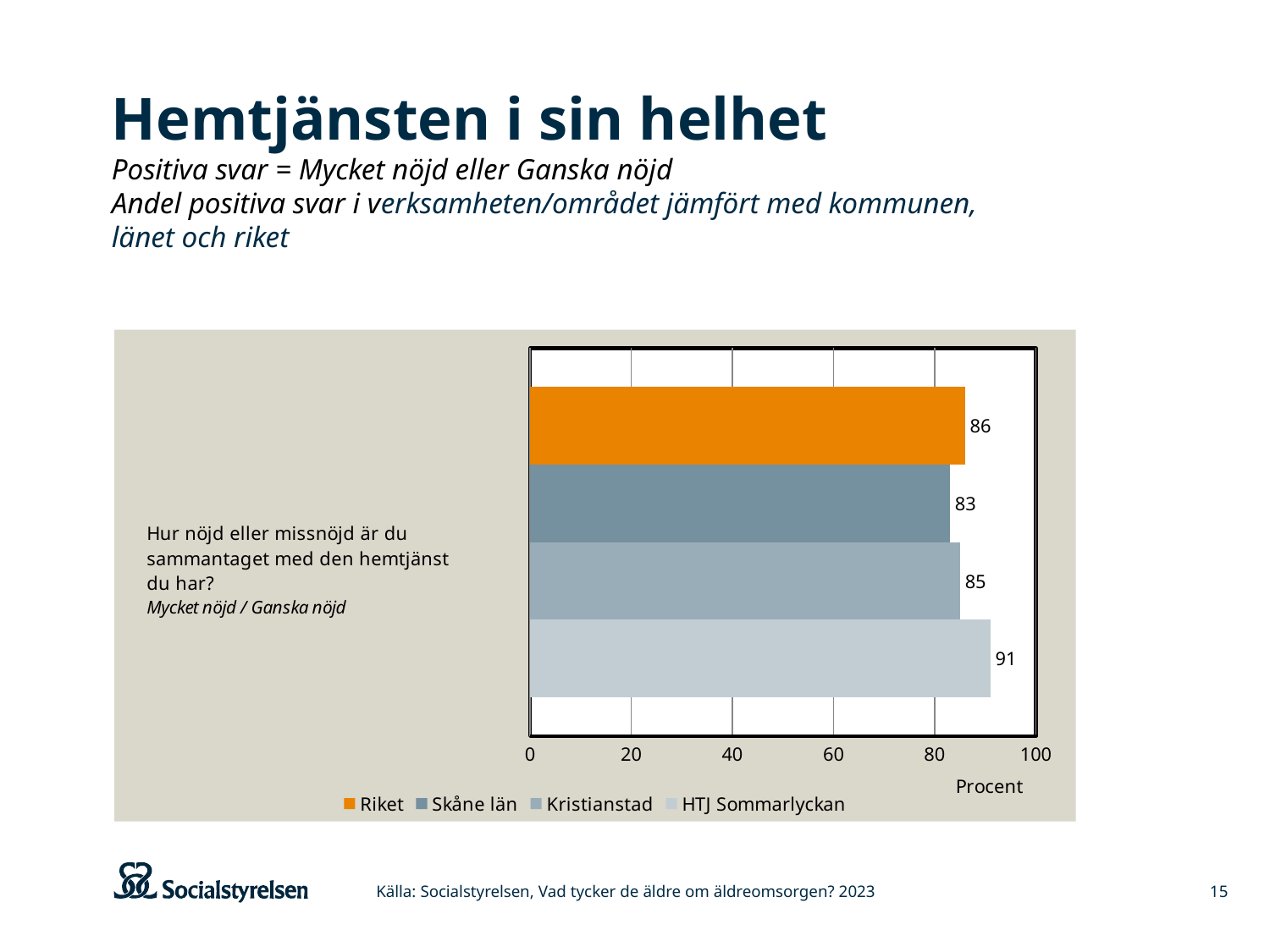
What is the value for Kristianstad? 85 What is the difference between the values for HTJ Sommarlyckan and Skåne län? 8 What is the value for Skåne län? 83 Which series has the lowest value? Skåne län Which is larger, the value for Riket or the value for HTJ Sommarlyckan? HTJ Sommarlyckan What is the label on the horizontal axis of the chart? Procent What is the difference between the values for Riket and Kristianstad? 1 What is the value for Riket? 86 What kind of chart is shown on the slide? Bar chart What is the value for HTJ Sommarlyckan? 91 Which series has the highest value? HTJ Sommarlyckan How many series does the legend list? 4